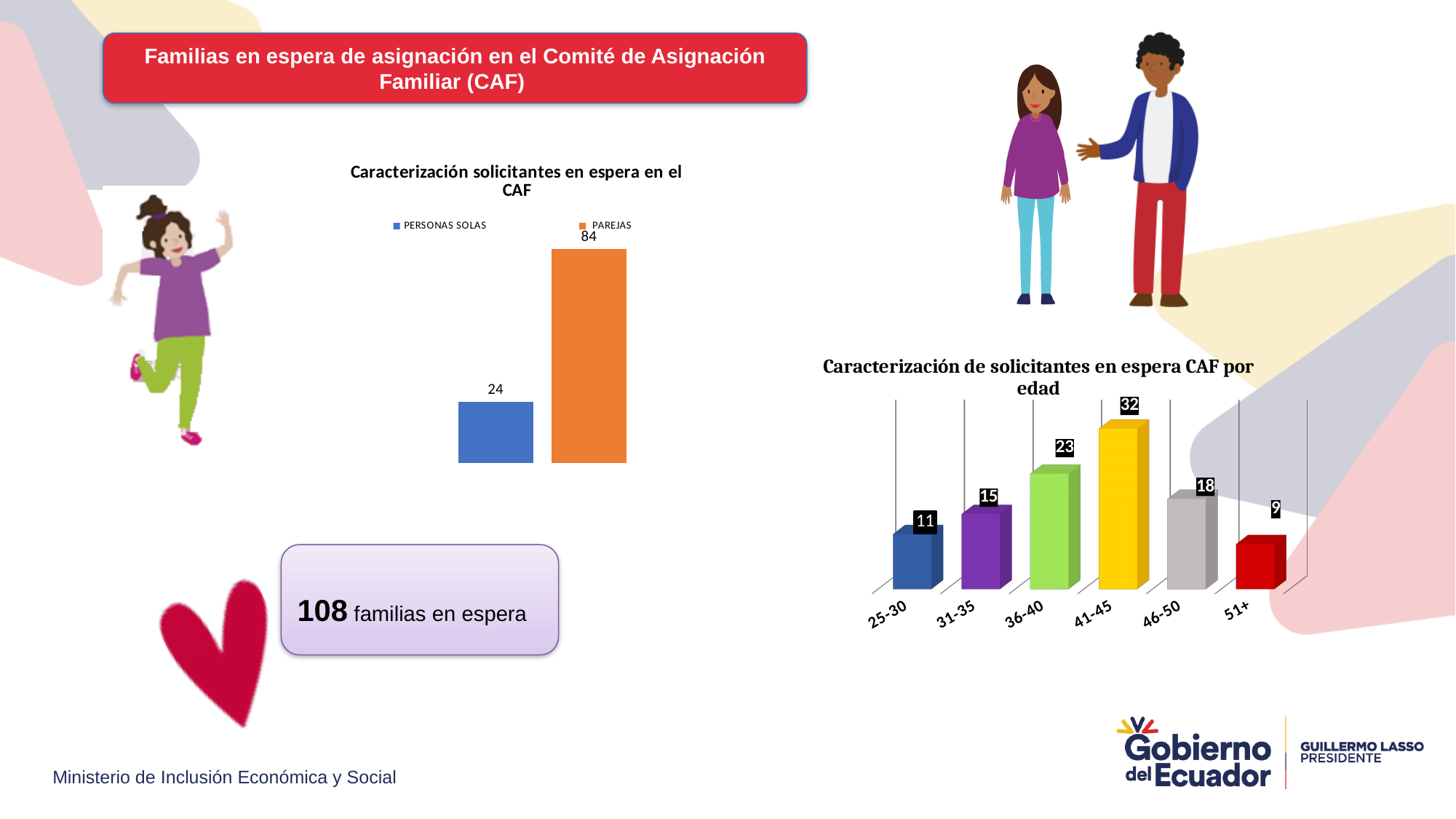
In the chart 'Caracterización solicitantes en espera en el CAF', which is larger, PERSONAS SOLAS or PAREJAS? PAREJAS In the chart 'Caracterización de solicitantes en espera CAF por edad', what is the value for the 25-30 age group? 11 In the chart 'Caracterización de solicitantes en espera CAF por edad', which age group has the lowest value? 51+ In the chart 'Caracterización de solicitantes en espera CAF por edad', which age group has the highest value? 41-45 In the chart 'Caracterización solicitantes en espera en el CAF', what is the value for PERSONAS SOLAS? 24 In the chart 'Caracterización solicitantes en espera en el CAF', how many entries does the legend list? 2 In the chart 'Caracterización solicitantes en espera en el CAF', what is the value for PAREJAS? 84 In the chart 'Caracterización de solicitantes en espera CAF por edad', what is the difference between the 36-40 and 46-50 age groups? 5 In the chart 'Caracterización de solicitantes en espera CAF por edad', what is the value for the 41-45 age group? 32 In the chart 'Caracterización solicitantes en espera en el CAF', what is the difference between PAREJAS and PERSONAS SOLAS? 60 In the chart 'Caracterización de solicitantes en espera CAF por edad', how many age groups are shown? 6 What kind of chart is 'Caracterización de solicitantes en espera CAF por edad'? Bar chart